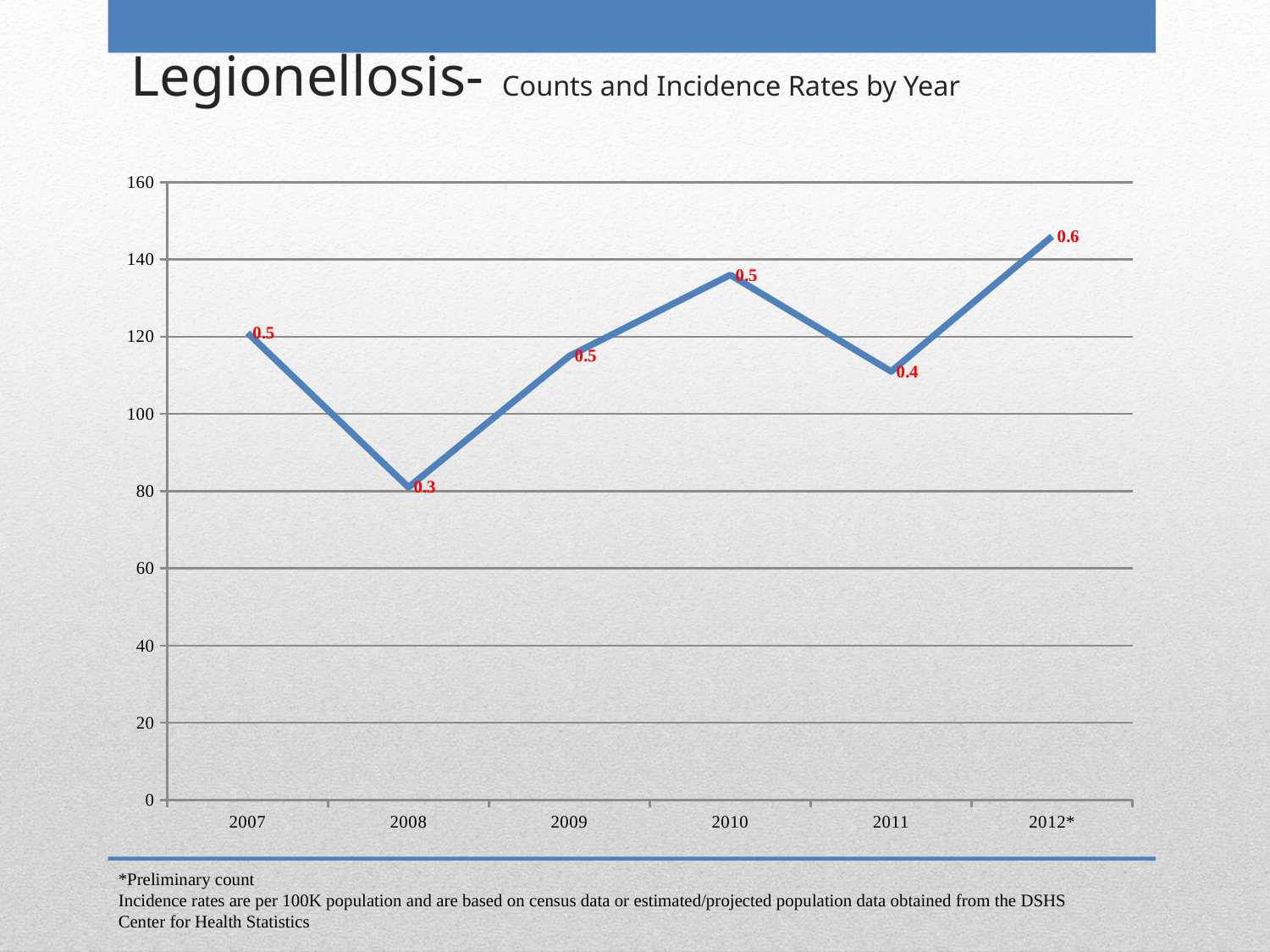
How many years are plotted on the x axis of the chart? 6 Is the count for 2012* greater or less than 140? greater Which year has the larger count, 2010 or 2011? 2010 What type of chart is shown on the slide? line chart What incidence rate label is shown for 2008? 0.3 Is the count for 2008 greater or less than 100? less Which year has the highest count on the chart? 2012* What incidence rate label is shown for 2012*? 0.6 Which year has the lowest count on the chart? 2008 Is the count for 2010 greater or less than 120? greater Does the count rise or fall from 2011 to 2012*? rise What incidence rate label is shown for 2011? 0.4